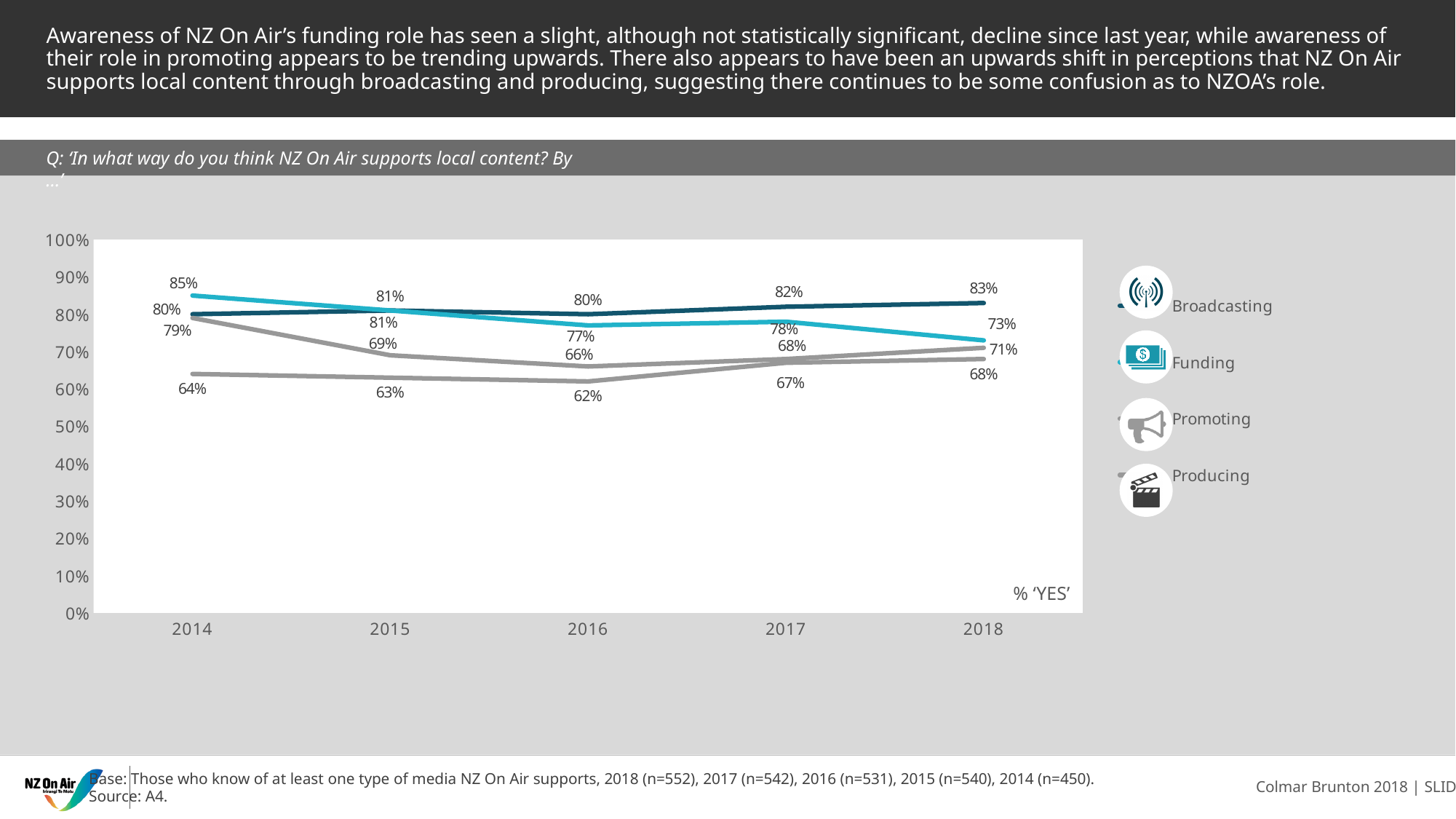
Does the Funding line generally rise or fall from 2014 to 2018? Fall In which year is the Funding value lowest? 2018 In which year is the Funding value highest? 2014 How many series does the legend list? 4 What is the value for Broadcasting in 2016? 80% Which is larger in 2018, Broadcasting or Funding? Broadcasting What is the difference between the Funding value in 2014 and in 2018? 12% What is the value for Broadcasting in 2018? 83% How many years are shown on the x axis? 5 What is the value for Funding in 2018? 73% What type of chart is shown on the slide? Line chart What is the value for Funding in 2014? 85%